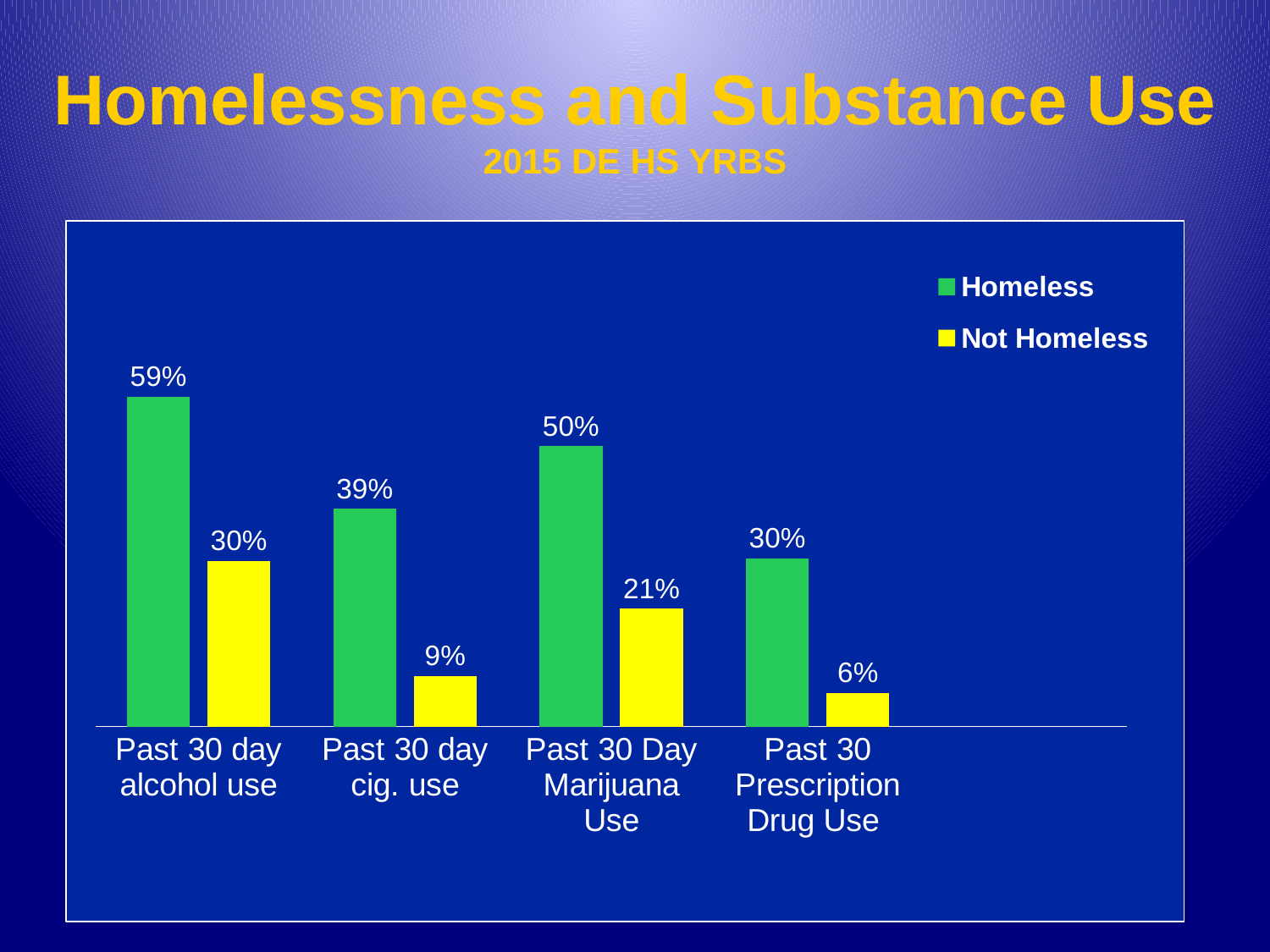
Which category has the lowest Not Homeless value? Past 30 Prescription Drug Use Which is larger: the Homeless value for Past 30 Prescription Drug Use or the Not Homeless value for Past 30 Day Marijuana Use? Homeless value for Past 30 Prescription Drug Use How many categories are shown on the x axis? 4 What is the value for Homeless for Past 30 Day Marijuana Use? 50% What kind of chart is shown on the slide? Bar chart What is the value for Not Homeless for Past 30 day cig. use? 9% What is the value for Homeless for Past 30 day alcohol use? 59% How many series does the legend list? 2 Which category has the highest Homeless value? Past 30 day alcohol use What is the value for Not Homeless for Past 30 Prescription Drug Use? 6% What is the difference between the Homeless and Not Homeless values for Past 30 Day Marijuana Use? 29% What is the difference between the Homeless and Not Homeless values for Past 30 day cig. use? 30%